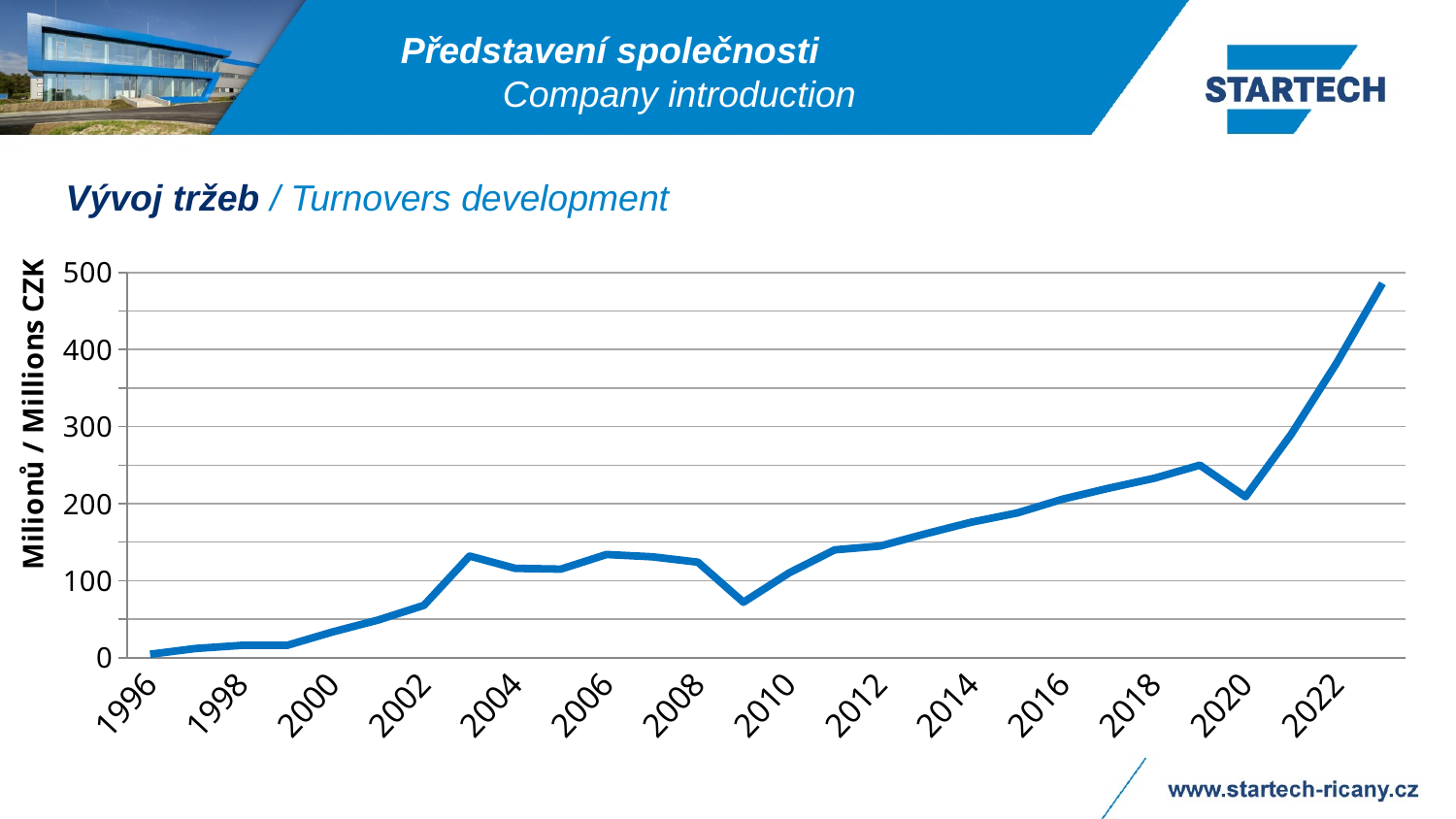
How many year labels are shown on the x axis? 14 Is the value for 2014 greater or less than 200? less Overall, do the turnover values rise or fall from 1996 to the end of the series? rise Which labelled year has the lowest turnover value? 1996 What kind of chart is shown on the slide? line chart Is the value for 2002 greater or less than 100? less Is the value for 2020 greater or less than 300? less Which is larger, the value for 2012 or the value for 2010? 2012 What is the label on the vertical axis? Milionů / Millions CZK